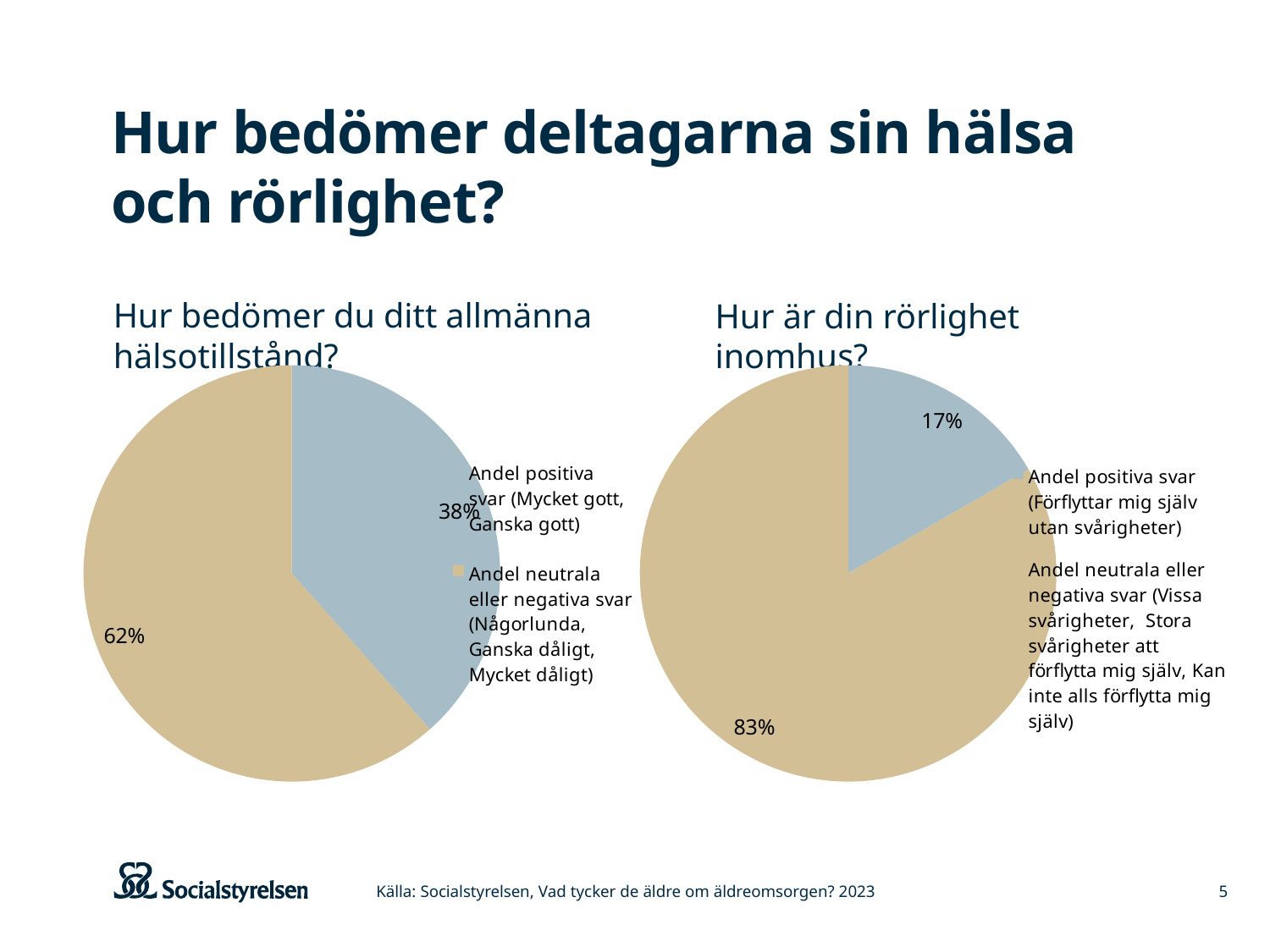
In the left chart, what is the difference in percentage points between the neutral/negative share and the positive share? 24 In the chart titled "Hur är din rörlighet inomhus?", what share is labelled for "Andel neutrala eller negativa svar"? 83% Which chart shows a larger share of positive answers, the left one (hälsotillstånd) or the right one (rörlighet inomhus)? the left one (hälsotillstånd) In the chart titled "Hur är din rörlighet inomhus?", what share is labelled for "Andel positiva svar"? 17% In the right chart, which category has the smallest slice? Andel positiva svar In the chart titled "Hur bedömer du ditt allmänna hälsotillstånd?", what share is labelled for "Andel neutrala eller negativa svar"? 62% In the right chart, what is the difference in percentage points between the neutral/negative share and the positive share? 66 In the left chart, which colour represents "Andel positiva svar"? blue How many slices does the chart titled "Hur är din rörlighet inomhus?" have? 2 In the chart titled "Hur bedömer du ditt allmänna hälsotillstånd?", what share is labelled for "Andel positiva svar"? 38% In the left chart, which category has the largest slice? Andel neutrala eller negativa svar What type of chart is used on this slide? pie chart